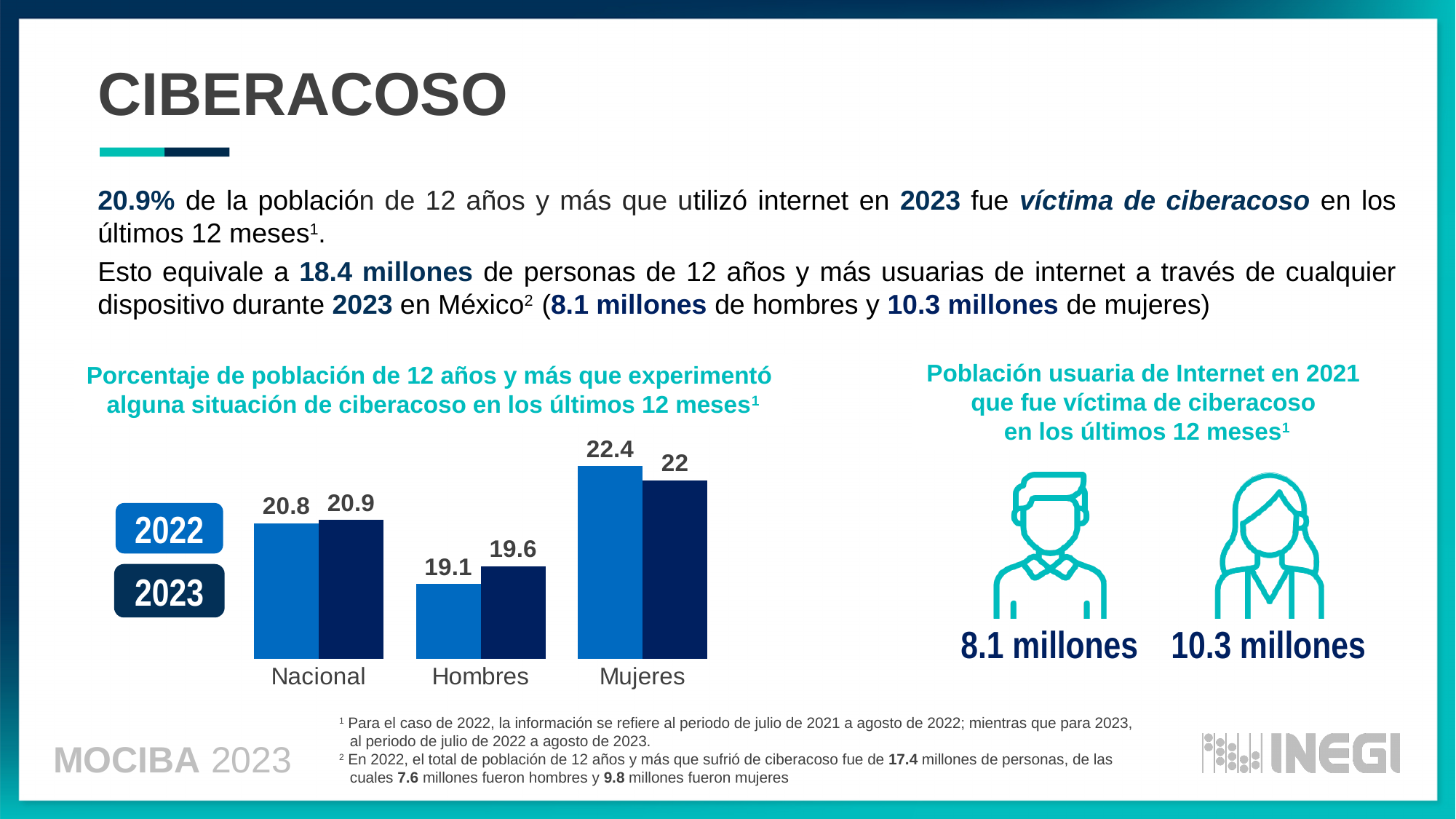
In the bar chart, what is the difference between the 2023 and 2022 values for Hombres? 0.5 In the bar chart, what is the value for Mujeres in 2023? 22 In the bar chart, which series is shown in the darker navy colour? 2023 In the bar chart, which is larger for Mujeres: the 2022 value or the 2023 value? 2022 In the bar chart, what is the value for Hombres in 2022? 19.1 In the bar chart, what is the difference between the Mujeres and Hombres values for 2022? 3.3 In the bar chart, which category has the lowest value for 2023? Hombres How many categories are shown on the x axis of the bar chart? 3 How many series does the legend of the bar chart list? 2 In the bar chart, what is the value for Nacional in 2023? 20.9 In the bar chart, which category has the highest value for 2022? Mujeres What kind of chart is shown on the left of the slide? Bar chart